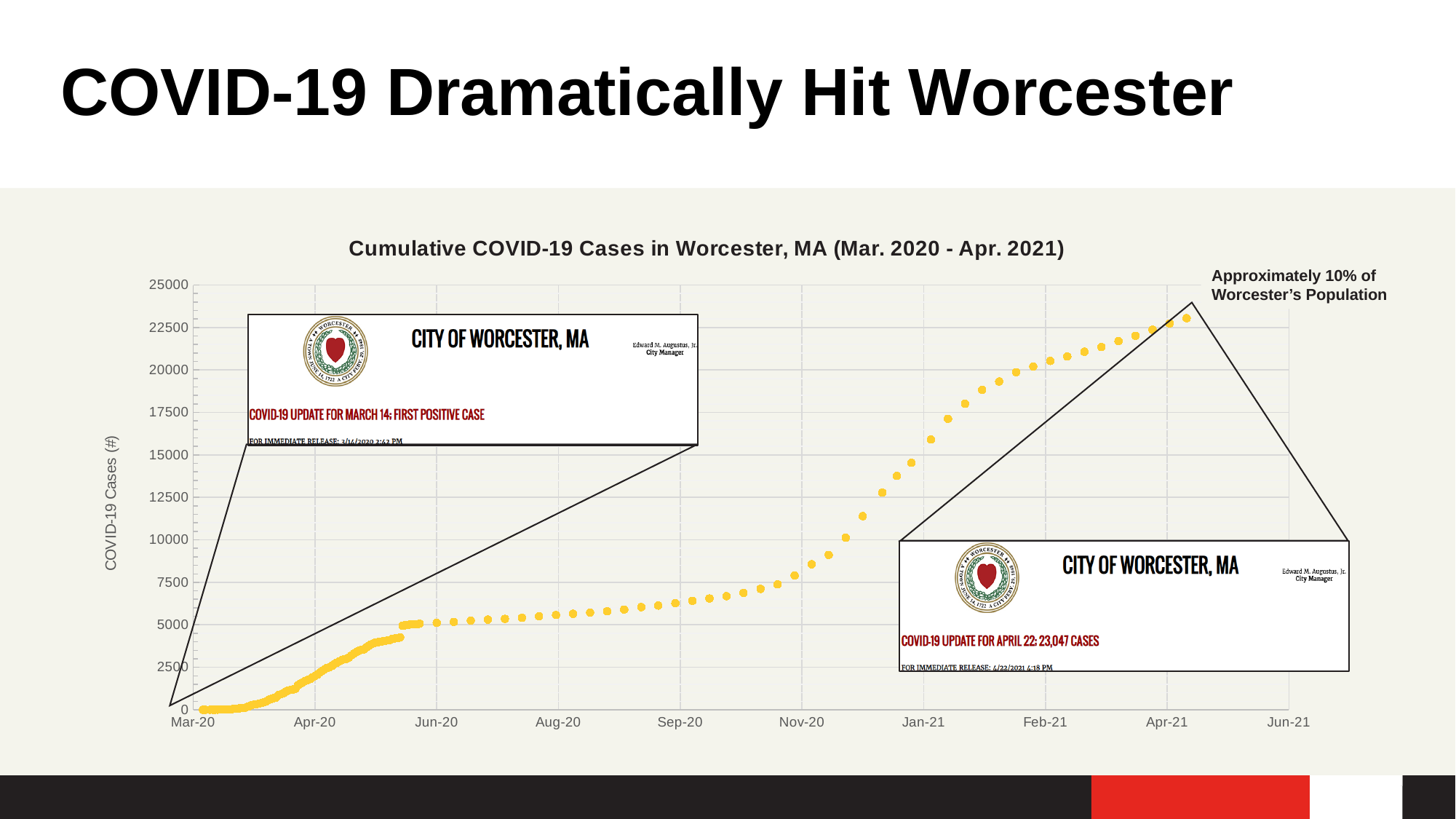
What is the label on the vertical axis of the chart? COVID-19 Cases (#) Is the cumulative case value at Aug-20 greater or less than 7500? less What kind of chart is shown on the slide? scatter chart What is the highest value shown on the vertical axis? 25000 Is the cumulative case value at Jan-21 greater or less than 12500? greater Is the cumulative case value at Nov-20 greater or less than 5000? greater Do the cumulative case values rise or fall from Mar-20 to Apr-21? rise Which has the larger cumulative case value, Apr-20 or Apr-21? Apr-21 According to the callout on the chart, how many cumulative COVID-19 cases were reported in the April 22 update? 23,047 How many month labels are shown along the horizontal axis? 10 What is the title of the chart? Cumulative COVID-19 Cases in Worcester, MA (Mar. 2020 - Apr. 2021)